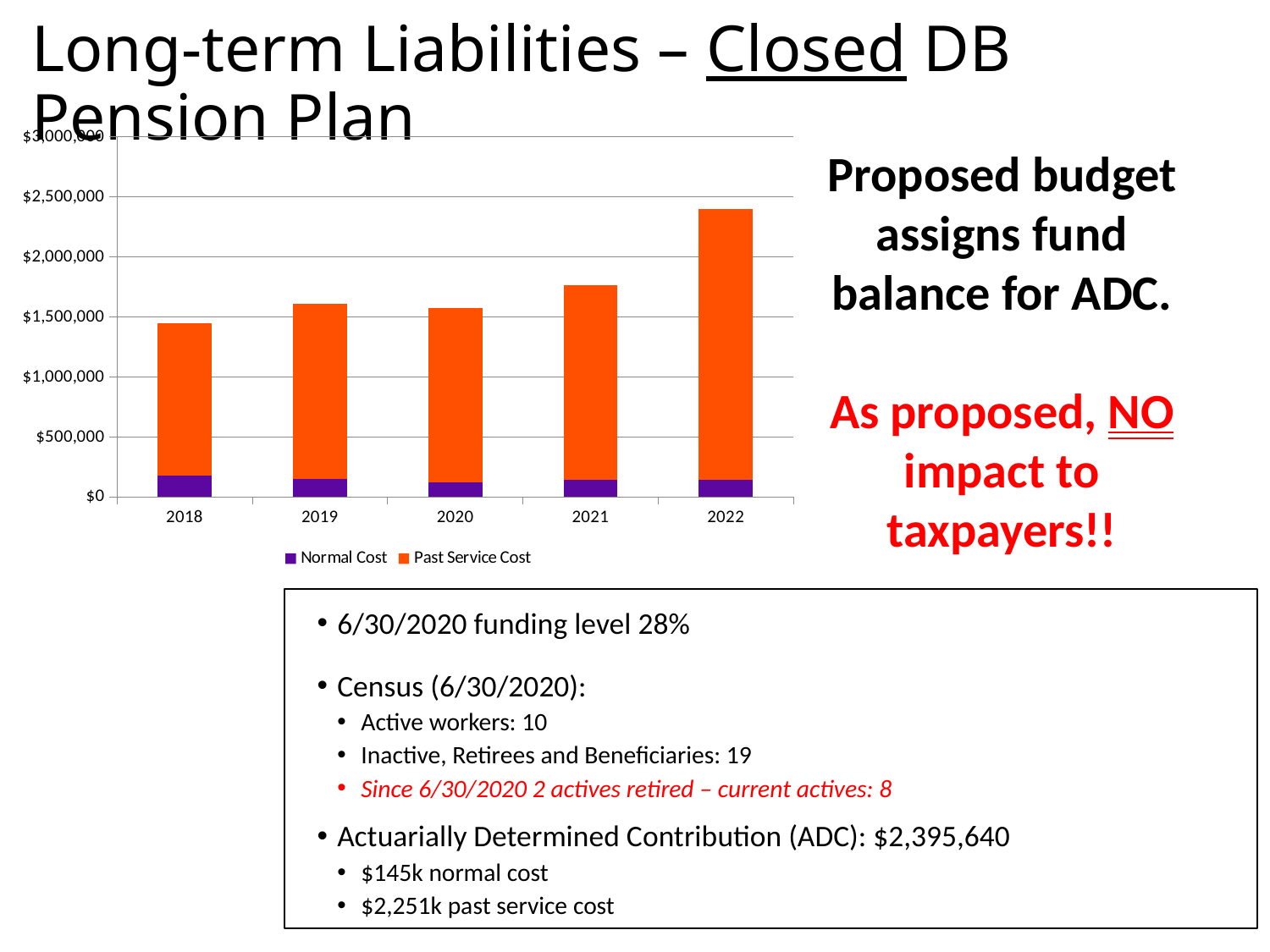
Which year has the larger total bar, 2018 or 2021? 2021 Is the total value for 2021 greater or less than $1,500,000? greater Which year has the tallest stacked bar in the chart? 2022 How many years are shown on the x axis of the chart? 5 Is the total value for 2022 greater or less than $2,000,000? greater Which year has the larger total bar, 2021 or 2022? 2022 What colour represents Normal Cost in the chart? Purple Is the total value for 2022 greater or less than $2,500,000? less How many series does the chart legend list? 2 Which series makes up the larger portion of each stacked bar, Normal Cost or Past Service Cost? Past Service Cost Which year has the shortest stacked bar in the chart? 2018 What kind of chart is shown on the slide? Stacked bar chart